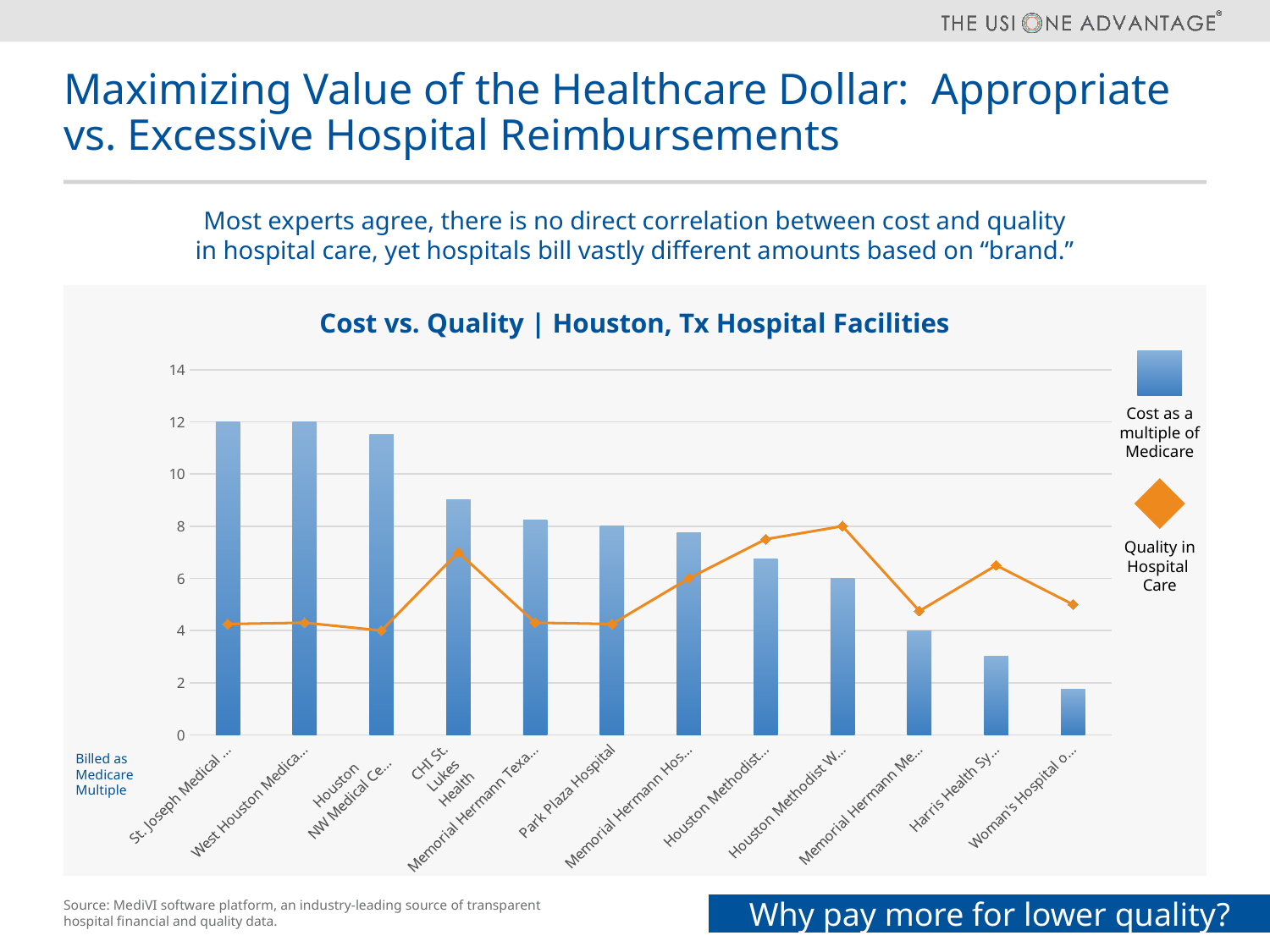
How many series does the legend list? 2 What kind of chart is shown on the slide? A bar chart combined with a line Is the Quality in Hospital Care value for Houston Methodist W... greater or less than 6? greater How many hospital facilities are plotted on the x axis? 12 Is the cost as a multiple of Medicare for Park Plaza Hospital greater or less than 10? less Is the cost as a multiple of Medicare for Harris Health Sy... greater or less than 4? less What is the title of the chart? Cost vs. Quality | Houston, Tx Hospital Facilities Which has the larger cost as a multiple of Medicare, Park Plaza Hospital or Harris Health Sy...? Park Plaza Hospital Do the cost bars rise or fall from left to right across the x axis? fall Which hospital has the highest Quality in Hospital Care value? Houston Methodist W... Which hospital has the lowest cost as a multiple of Medicare? Woman's Hospital o...